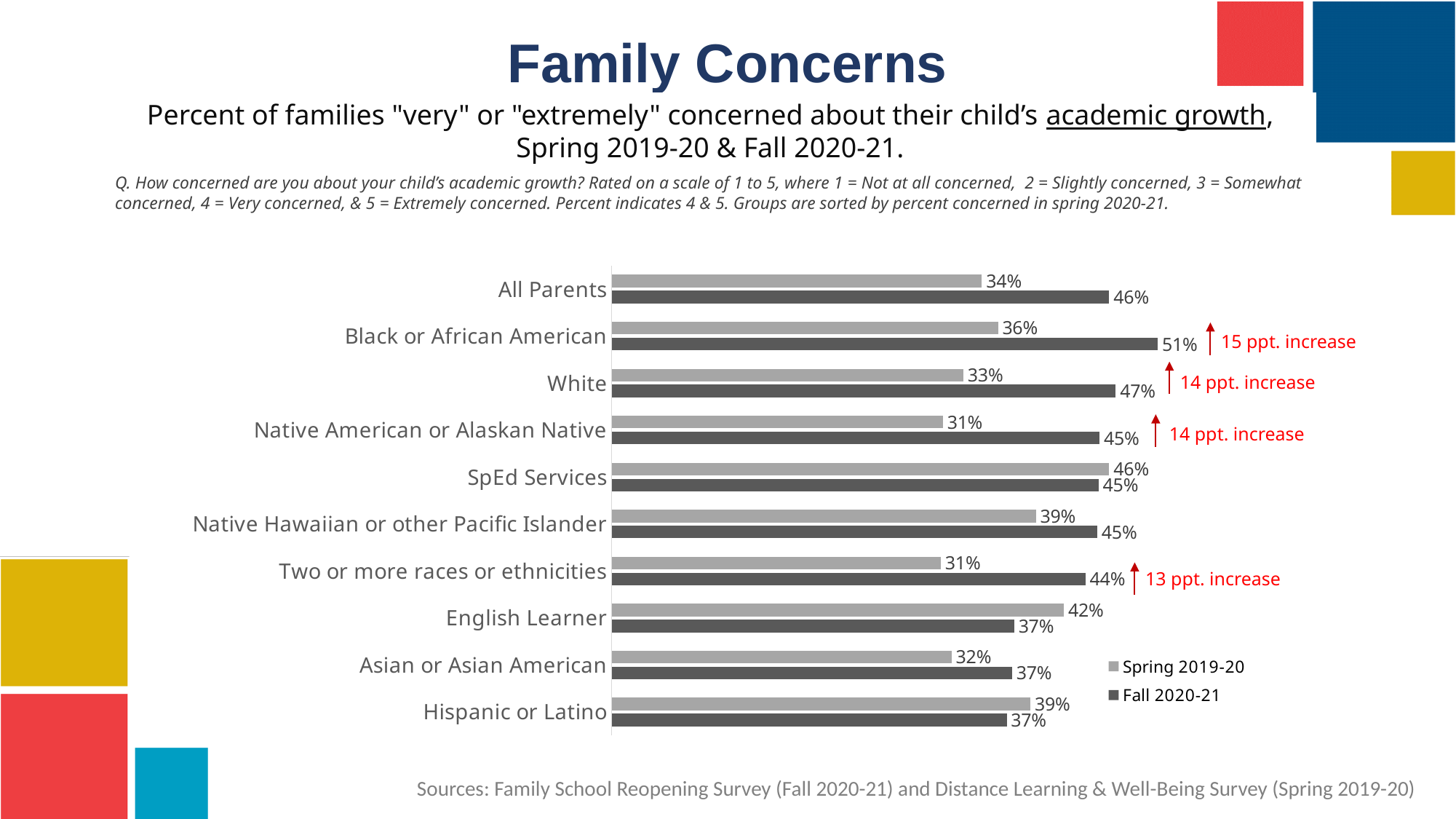
What is the Spring 2019-20 value for English Learner families? 42% What are the two series listed in the legend? Spring 2019-20 and Fall 2020-21 What is the Fall 2020-21 value for All Parents? 46% How many groups are shown on the chart? 10 What is the difference between the Fall 2020-21 and Spring 2019-20 values for White families? 14 percentage points What kind of chart is shown on the slide? Bar chart Which group has the highest Fall 2020-21 value? Black or African American What is the Fall 2020-21 value for Black or African American families? 51% Which group has the highest Spring 2019-20 value? SpEd Services How many series does the legend list? 2 Which group has the lowest Spring 2019-20 value? Native American or Alaskan Native and Two or more races or ethnicities (both 31%) Which is larger for SpEd Services: the Spring 2019-20 value or the Fall 2020-21 value? Spring 2019-20